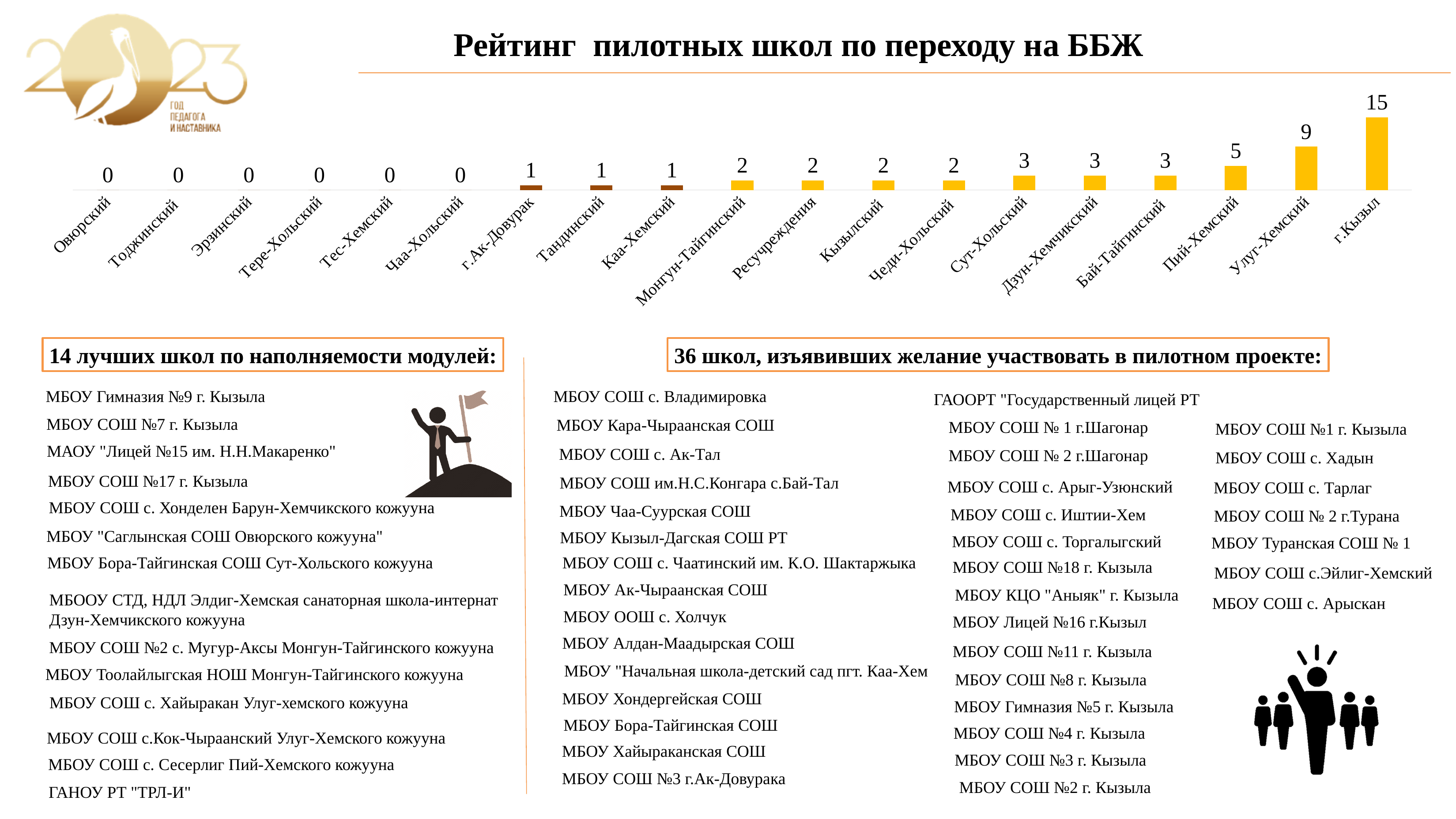
What is the difference between the values for Пий-Хемский and Сут-Хольский? 2 Which category has the highest value? г.Кызыл How many categories are shown on the x axis of the chart? 19 Which is larger, the value for Кызылский or the value for Бай-Тайгинский? Бай-Тайгинский What is the value for Улуг-Хемский? 9 What is the value for г.Кызыл? 15 Do the values rise or fall from left to right along the x axis? rise What is the value for Тандинский? 1 What kind of chart is shown on the slide? bar chart What is the title of the chart? Рейтинг пилотных школ по переходу на ББЖ What is the difference between the values for г.Кызыл and Улуг-Хемский? 6 What is the value for Пий-Хемский? 5